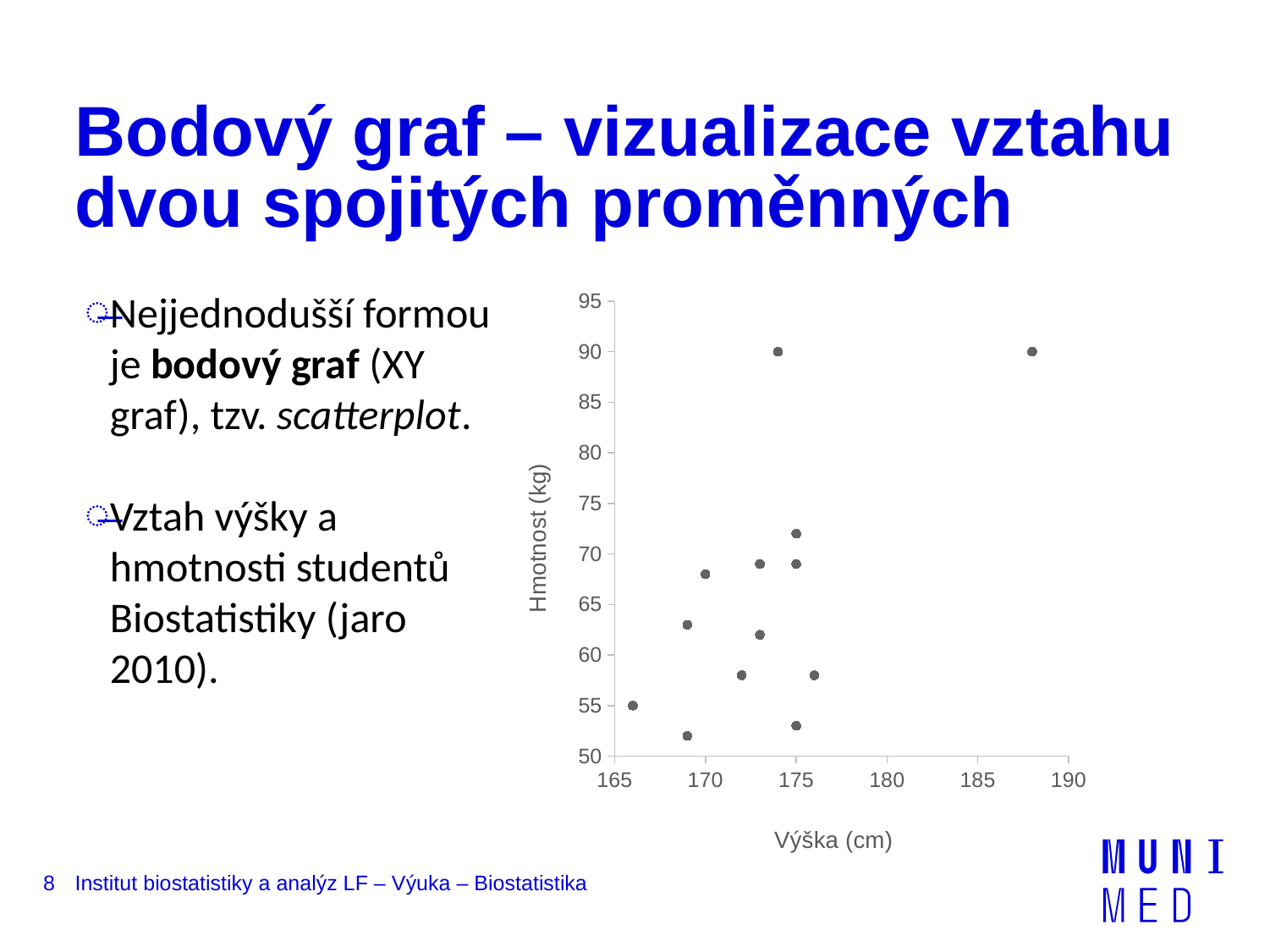
Is the weight of the point at a height of about 188 cm greater or less than 85? greater What is the label of the horizontal axis of the chart? Výška (cm) Is the largest height plotted on the chart greater or less than 185? greater Is the lowest weight plotted on the chart greater or less than 55? less How many points on the chart have a weight greater than 85 kg? 2 How many points on the chart have a height greater than 180 cm? 1 How many data points are plotted on the chart? 13 What kind of chart is shown on the slide? scatter plot What is the label of the vertical axis of the chart? Hmotnost (kg)